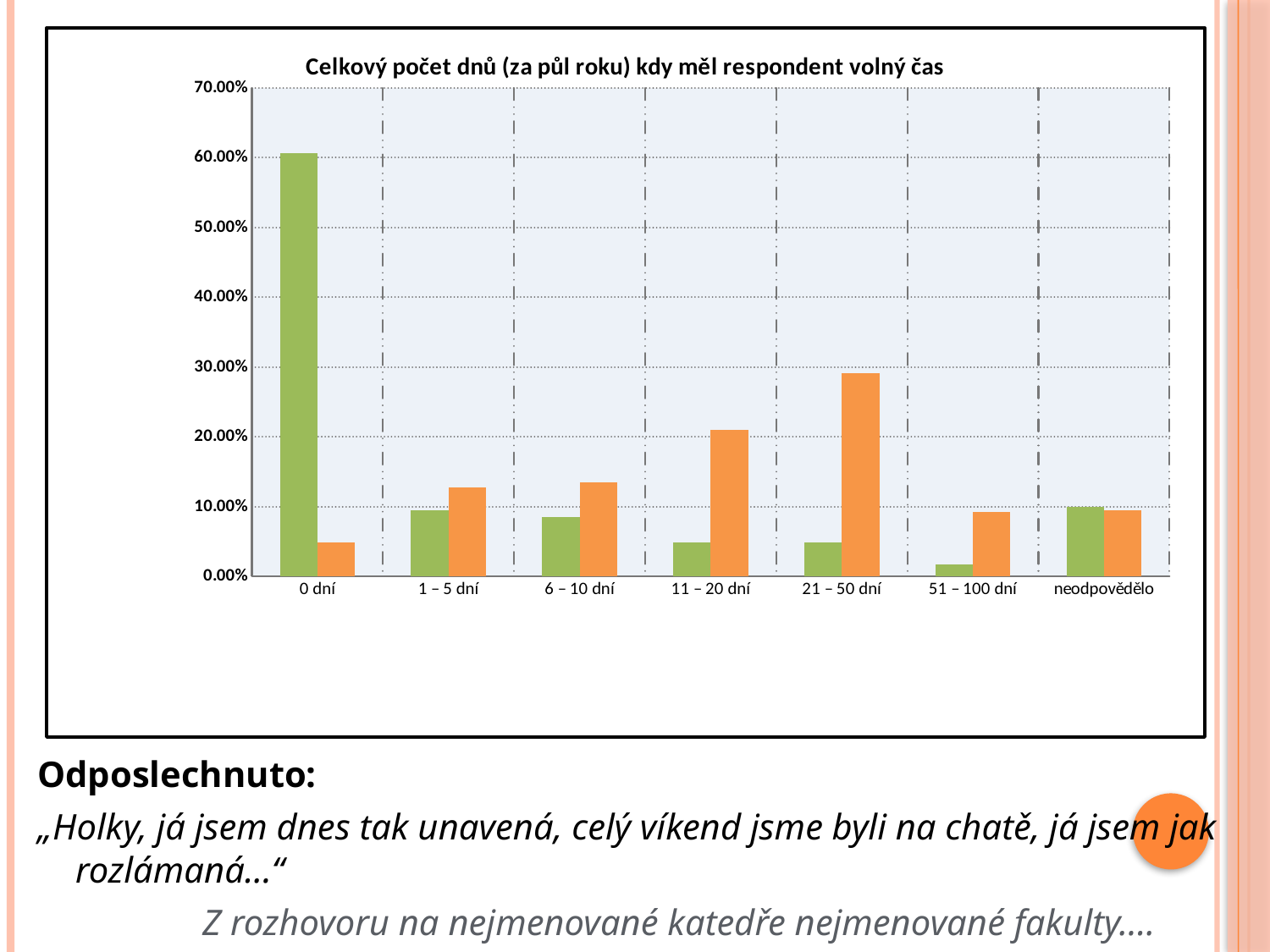
Is the orange bar for 21 – 50 dní greater or less than 30.00%? less Which category has the lowest green bar? 51 – 100 dní Which category has the highest green bar? 0 dní Which category has the highest orange bar? 21 – 50 dní Is the orange bar for 11 – 20 dní greater or less than 20.00%? greater What kind of chart is shown on the slide? bar chart For the category 11 – 20 dní, which bar is taller, the green one or the orange one? orange Is the green bar for 51 – 100 dní greater or less than 10.00%? less How many categories are shown on the x axis of the chart? 7 Which category has the lowest orange bar? 0 dní What is the title of the chart? Celkový počet dnů (za půl roku) kdy měl respondent volný čas